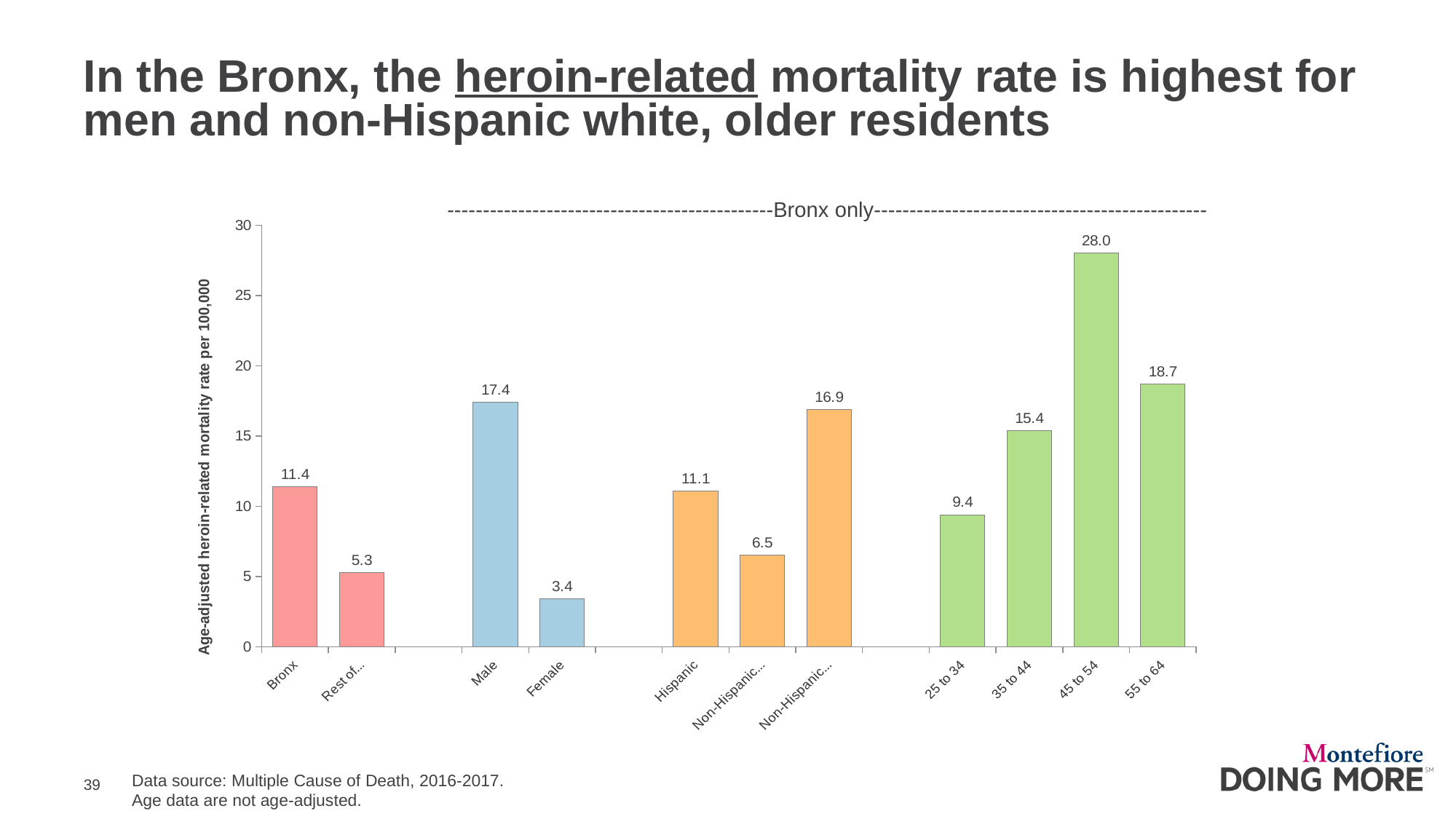
Which category has the highest heroin-related mortality rate on the chart? 45 to 54 How many bars are plotted on the chart? 11 What is the age-adjusted heroin-related mortality rate for the Bronx? 11.4 What is the heroin-related mortality rate for the 45 to 54 age group? 28.0 What is the heroin-related mortality rate for Male residents of the Bronx? 17.4 Which category has the lowest heroin-related mortality rate on the chart? Female What is the label on the vertical axis of the chart? Age-adjusted heroin-related mortality rate per 100,000 What is the heroin-related mortality rate for Hispanic residents of the Bronx? 11.1 What is the heroin-related mortality rate for Female residents of the Bronx? 3.4 Which has a higher heroin-related mortality rate, the 35 to 44 age group or the 55 to 64 age group? 55 to 64 What is the difference between the Male and Female heroin-related mortality rates? 14.0 What type of chart is shown on the slide? bar chart